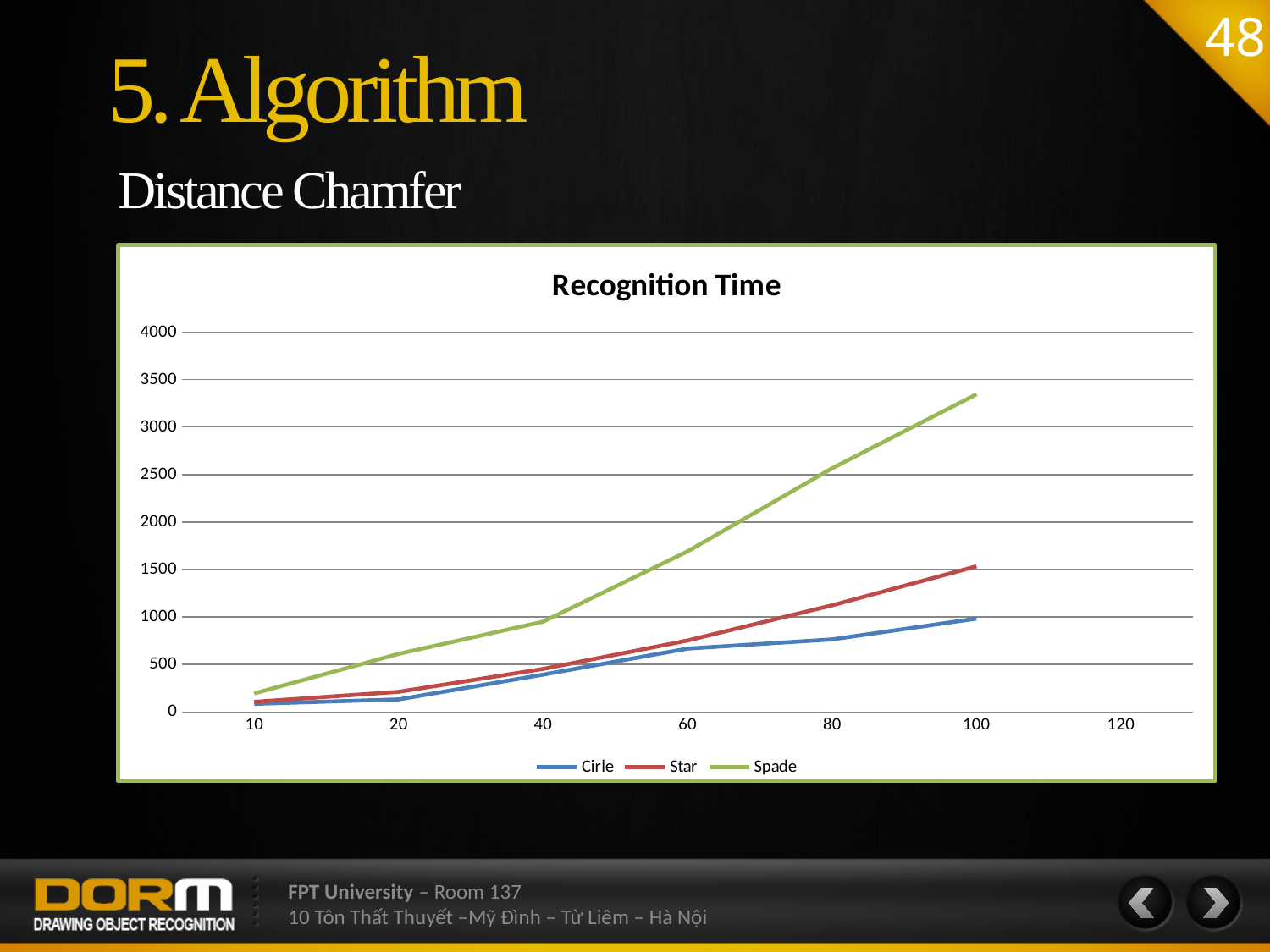
What is the title of the chart? Recognition Time Which series has the highest value at x = 100? Spade Which series has the lowest value at x = 100? Cirle How many series does the legend list? 3 Is the value for Cirle at x = 100 greater or less than 1500? less Is the value for Star at x = 100 greater or less than 1000? greater Is the value for Spade at x = 60 greater or less than 1000? greater What kind of chart is shown on the slide? line chart Do the values for Spade rise or fall as x increases from 10 to 100? rise At x = 60, which is larger, the value for Spade or the value for Star? Spade